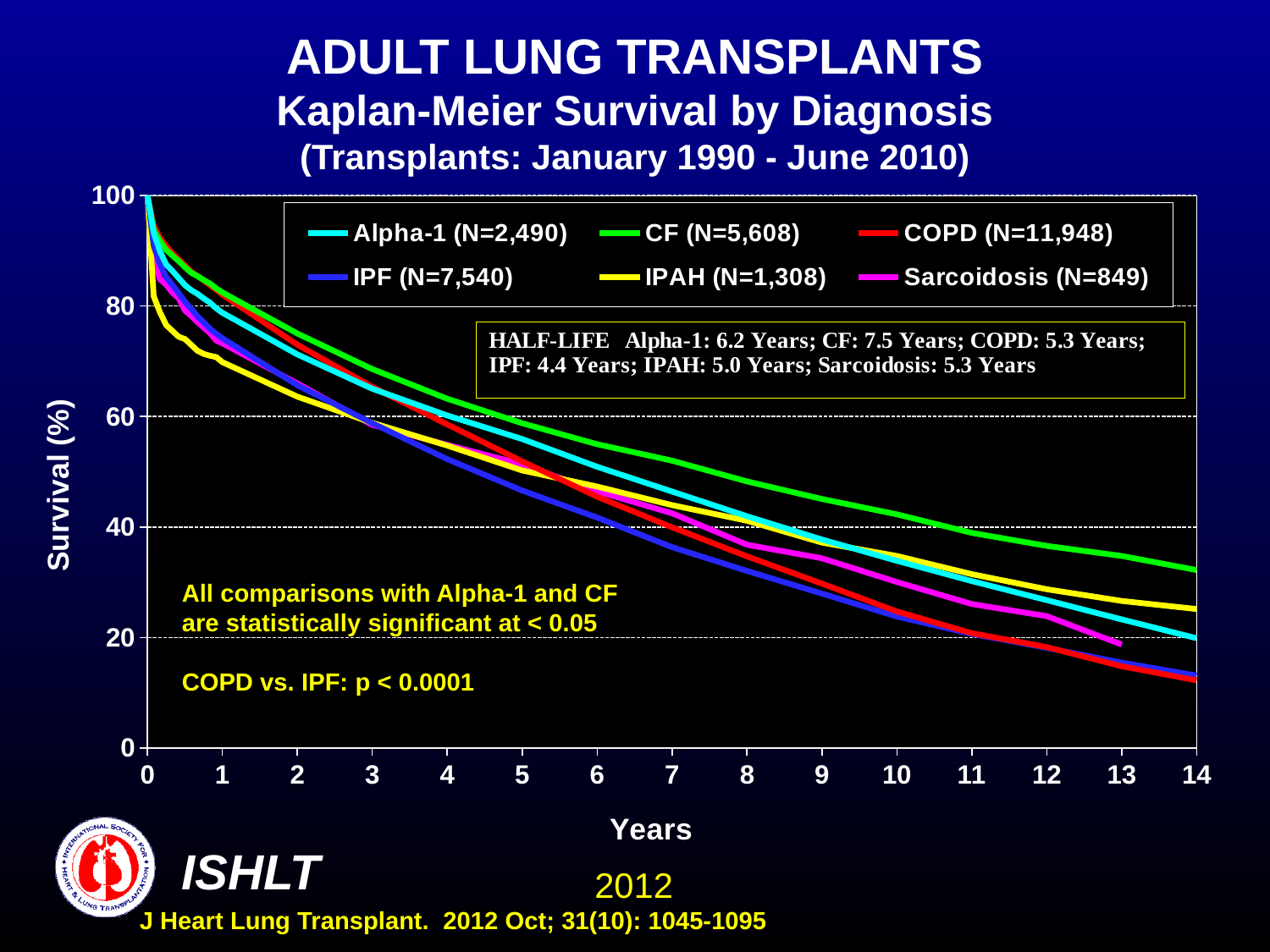
Is the survival for IPF at 14 years greater or less than 20? less What is the N for COPD shown in the legend? N=11,948 At 10 years, which has higher survival, CF or IPF? CF What is the difference between the half-life of CF and the half-life of IPF? 3.1 Years Is the survival for CF at 14 years greater or less than 20? greater What is the half-life for IPF according to the text box on the chart? 4.4 Years What is the half-life for Alpha-1 according to the text box on the chart? 6.2 Years What kind of chart is shown on the slide? line chart Do the survival curves rise or fall as years increase? fall Which diagnosis has the highest survival at 14 years? CF What is the half-life for CF according to the text box on the chart? 7.5 Years How many series does the legend list? 6